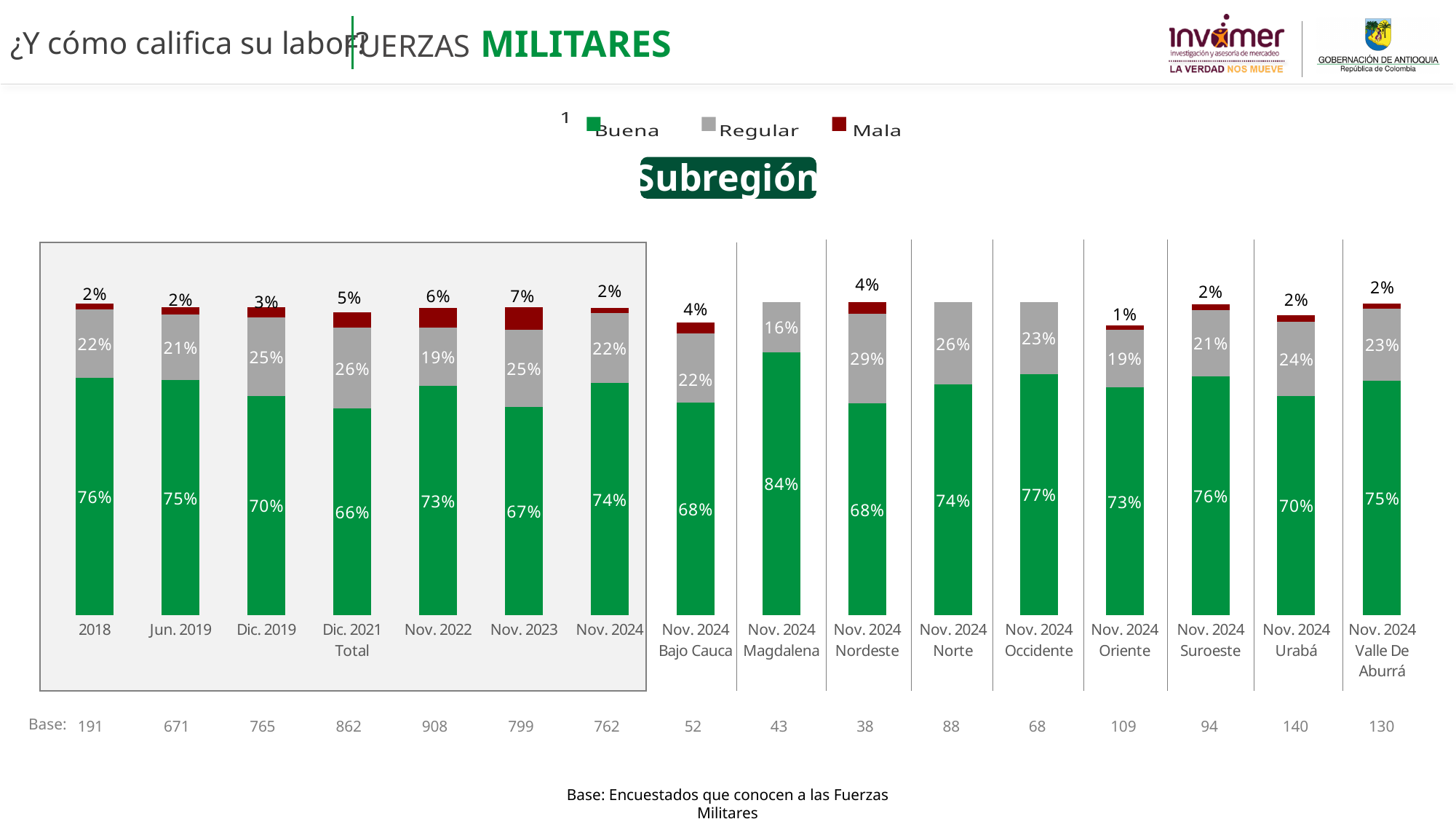
What is the 'Regular' percentage for the Nordeste subregion? 29% What is the difference in 'Mala' percentage between Nov. 2023 and Nov. 2024 (Total)? 5 percentage points How many series does the legend list? 3 Which period in the Total series has the lowest 'Buena' percentage? Dic. 2021 Which has a higher 'Buena' percentage, Occidente or Urabá? Occidente What is the base (number of respondents) for the Valle De Aburrá subregion? 130 Which subregion has the highest 'Buena' percentage? Magdalena Which period in the Total series has the highest 'Mala' percentage? Nov. 2023 What type of chart is shown on the slide? Stacked bar chart What is the 'Mala' percentage for Nov. 2023? 7% What percentage of respondents rated the Fuerzas Militares as 'Buena' in Nov. 2024 (Total)? 74% How many bars are shown in the chart? 16